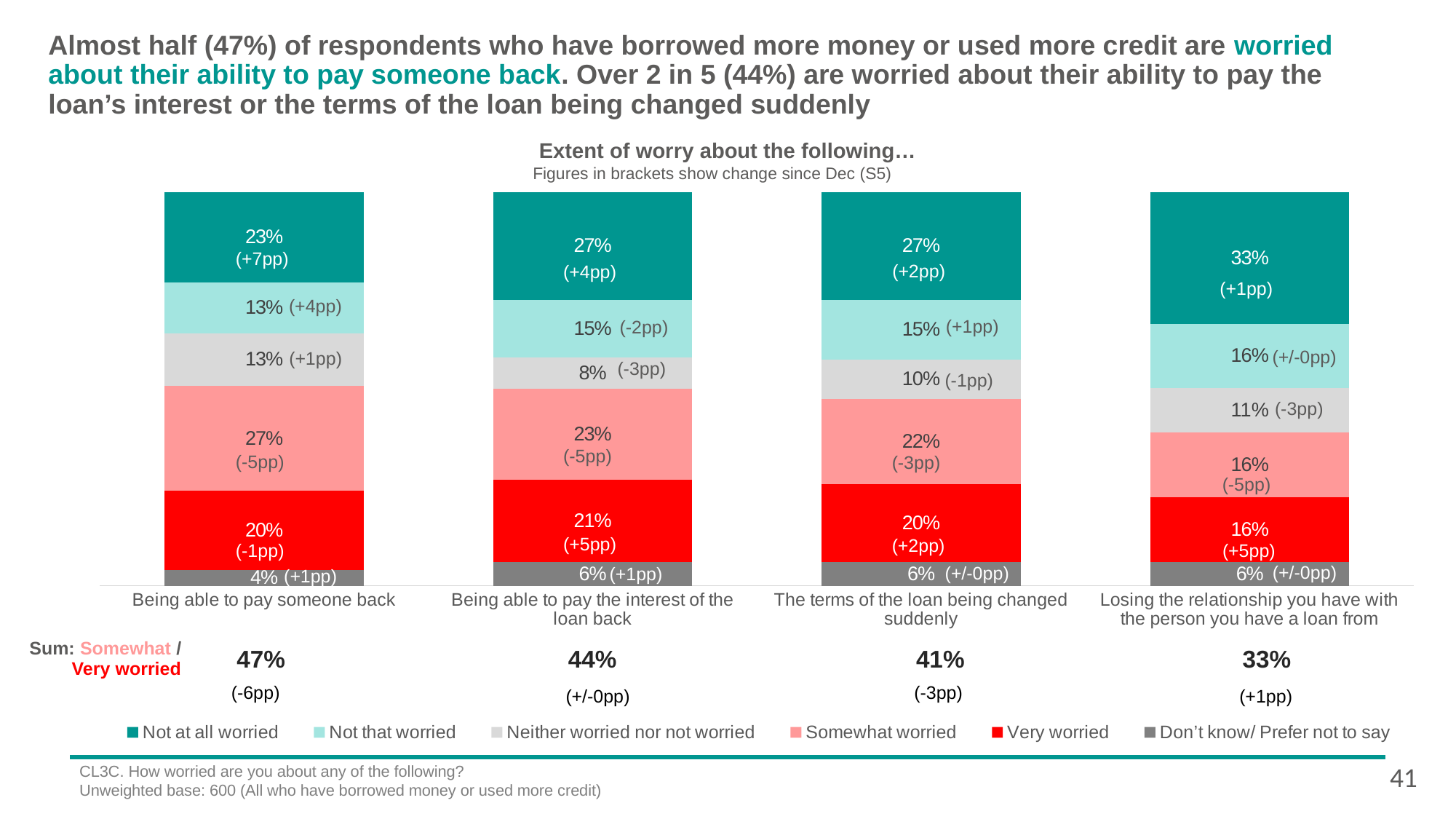
What percentage of respondents are 'Not at all worried' about losing the relationship they have with the person they have a loan from? 33% What percentage of respondents are 'Very worried' about being able to pay someone back? 20% What is the combined 'Somewhat / Very worried' sum shown for the terms of the loan being changed suddenly? 41% Which category has the lowest 'Somewhat worried' percentage? Losing the relationship you have with the person you have a loan from Which is larger: the 'Very worried' share for being able to pay the interest of the loan back, or the 'Very worried' share for the terms of the loan being changed suddenly? Being able to pay the interest of the loan back What is the 'Neither worried nor not worried' value for being able to pay the interest of the loan back? 8% How many categories are shown on the x axis of the chart? 4 What is the change since Dec (S5) shown for the 'Not at all worried' segment of being able to pay someone back? +7pp How many series does the legend list? 6 Which category has the highest 'Not at all worried' percentage? Losing the relationship you have with the person you have a loan from What type of chart is shown on the slide? Stacked bar chart What is the difference between the 'Somewhat worried' values for being able to pay someone back and for losing the relationship with the person you have a loan from? 11 percentage points